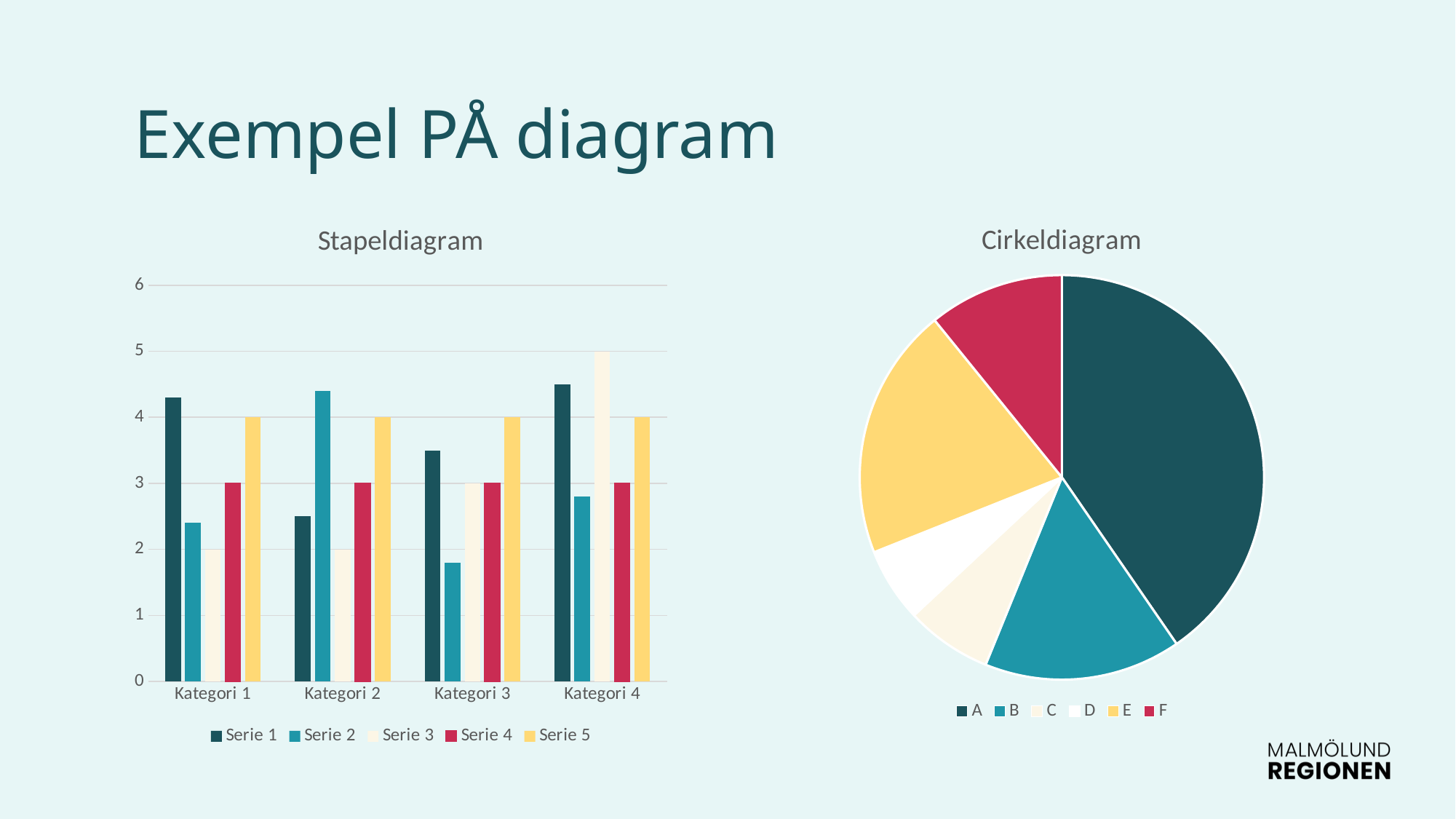
In the "Stapeldiagram" chart, is the value for Serie 2 in Kategori 3 greater or less than 2? less What kind of chart is the chart titled "Stapeldiagram"? bar chart In the "Cirkeldiagram" chart, which slice is the largest? A In the "Stapeldiagram" chart, how many categories are shown on the x axis? 4 In the "Stapeldiagram" chart, what is the value of Serie 5 for Kategori 2? 4 In the "Stapeldiagram" chart, how many series does the legend list? 5 In the "Cirkeldiagram" chart, how many slices does the pie have? 6 What kind of chart is the chart titled "Cirkeldiagram"? pie chart In the "Stapeldiagram" chart, which series has the highest value in Kategori 2? Serie 2 In the "Stapeldiagram" chart, is the value for Serie 1 in Kategori 1 greater or less than 4? greater In the "Stapeldiagram" chart, what is the value of Serie 3 for Kategori 4? 5 In the "Stapeldiagram" chart, what is the value of Serie 4 for Kategori 1? 3